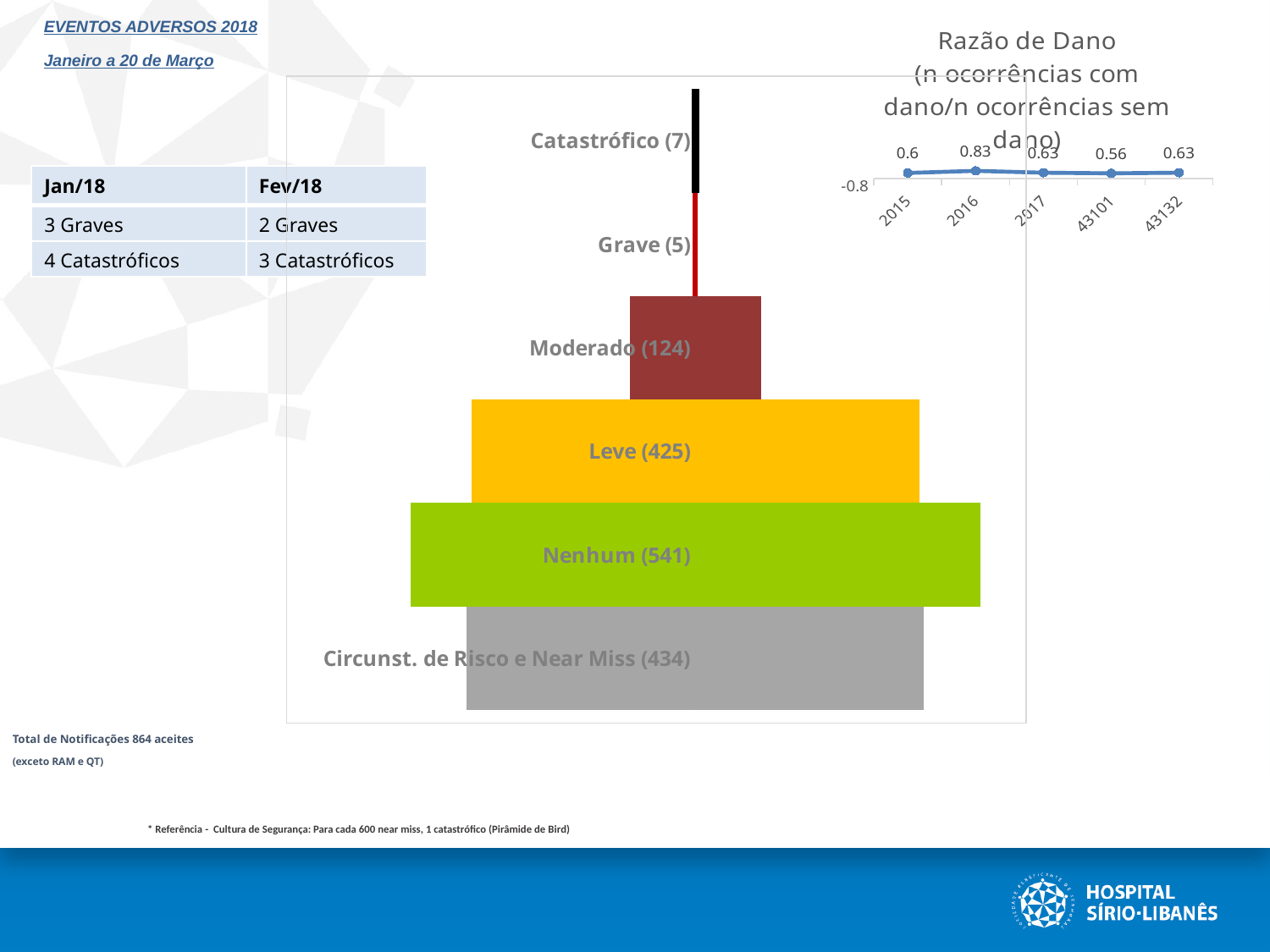
On the Razão de Dano line chart, what is the difference between the 2016 and 2017 values? 0.2 On the Razão de Dano line chart, what is the value for 2016? 0.83 What kind of chart is the Razão de Dano chart? Line chart On the Razão de Dano line chart, what is the value for 2015? 0.6 On the pyramid chart, which category has the lowest number of occurrences? Grave (5) On the pyramid chart, which category has the highest number of occurrences? Nenhum (541) How many categories does the pyramid chart show? 6 On the Razão de Dano line chart, which point has the highest value? 2016 On the pyramid chart, how many occurrences are labelled for the Leve category? 425 On the pyramid chart, how many occurrences are labelled for the Moderado category? 124 On the pyramid chart, what is the difference between the Nenhum and Leve counts? 116